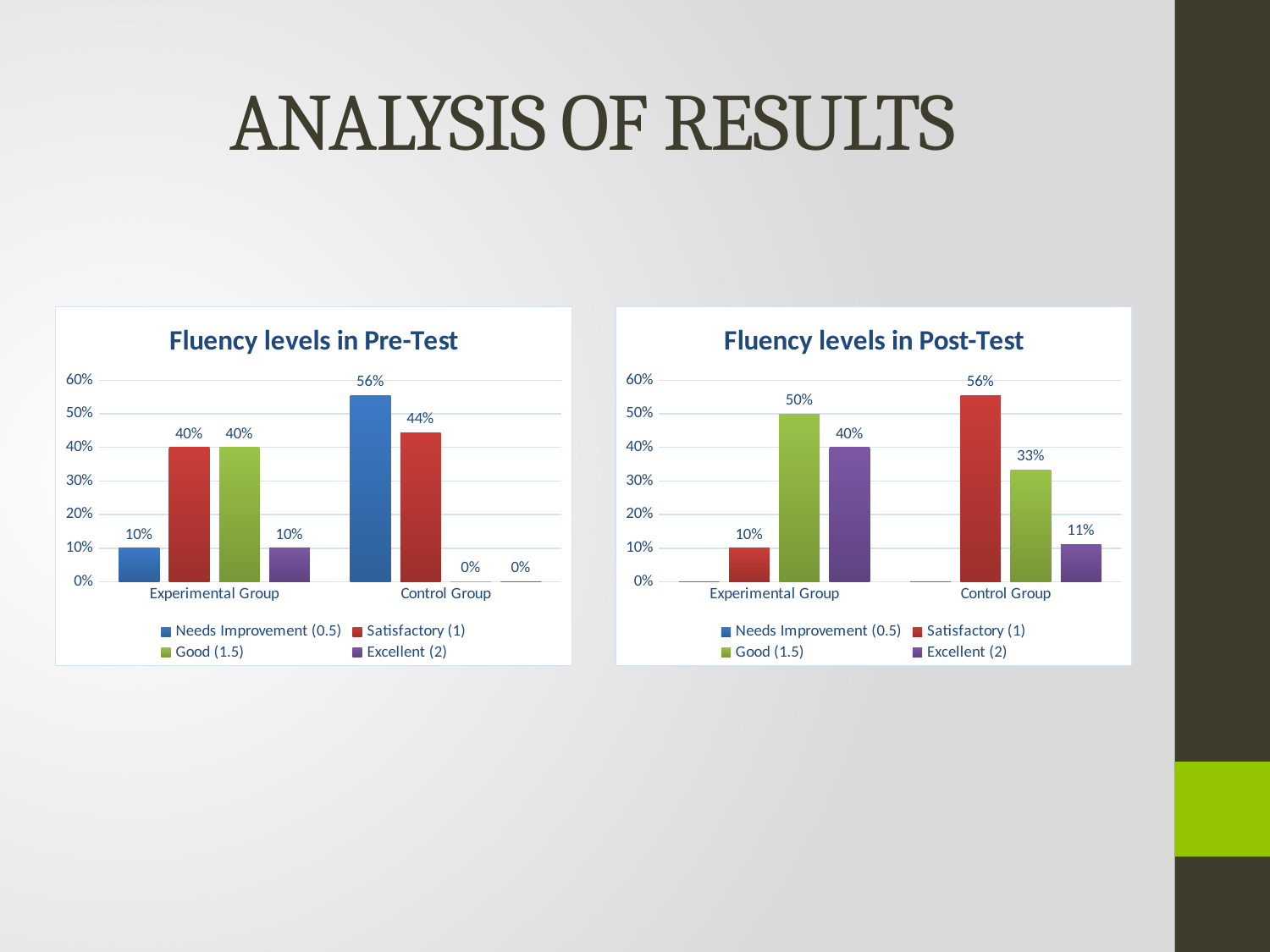
How many series does the legend of the 'Fluency levels in Pre-Test' chart list? 4 In the 'Fluency levels in Pre-Test' chart, what is the difference between Needs Improvement (0.5) and Satisfactory (1) in the Control Group? 12% In the 'Fluency levels in Post-Test' chart, what is the value for Excellent (2) in the Control Group? 11% In the 'Fluency levels in Pre-Test' chart, what is the value for Needs Improvement (0.5) in the Control Group? 56% In the 'Fluency levels in Post-Test' chart, what is the value for Good (1.5) in the Experimental Group? 50% In the 'Fluency levels in Post-Test' chart, which series has the highest value in the Control Group? Satisfactory (1) What kind of chart is 'Fluency levels in Post-Test'? Bar chart In the 'Fluency levels in Pre-Test' chart, what is the value for Excellent (2) in the Control Group? 0% In the 'Fluency levels in Post-Test' chart, what is the difference between Good (1.5) in the Experimental Group and Good (1.5) in the Control Group? 17% In the 'Fluency levels in Post-Test' chart, which is larger: Excellent (2) in the Experimental Group or Excellent (2) in the Control Group? Experimental Group How many groups are shown on the x axis of the 'Fluency levels in Post-Test' chart? 2 In the 'Fluency levels in Pre-Test' chart, which series has the highest value in the Control Group? Needs Improvement (0.5)